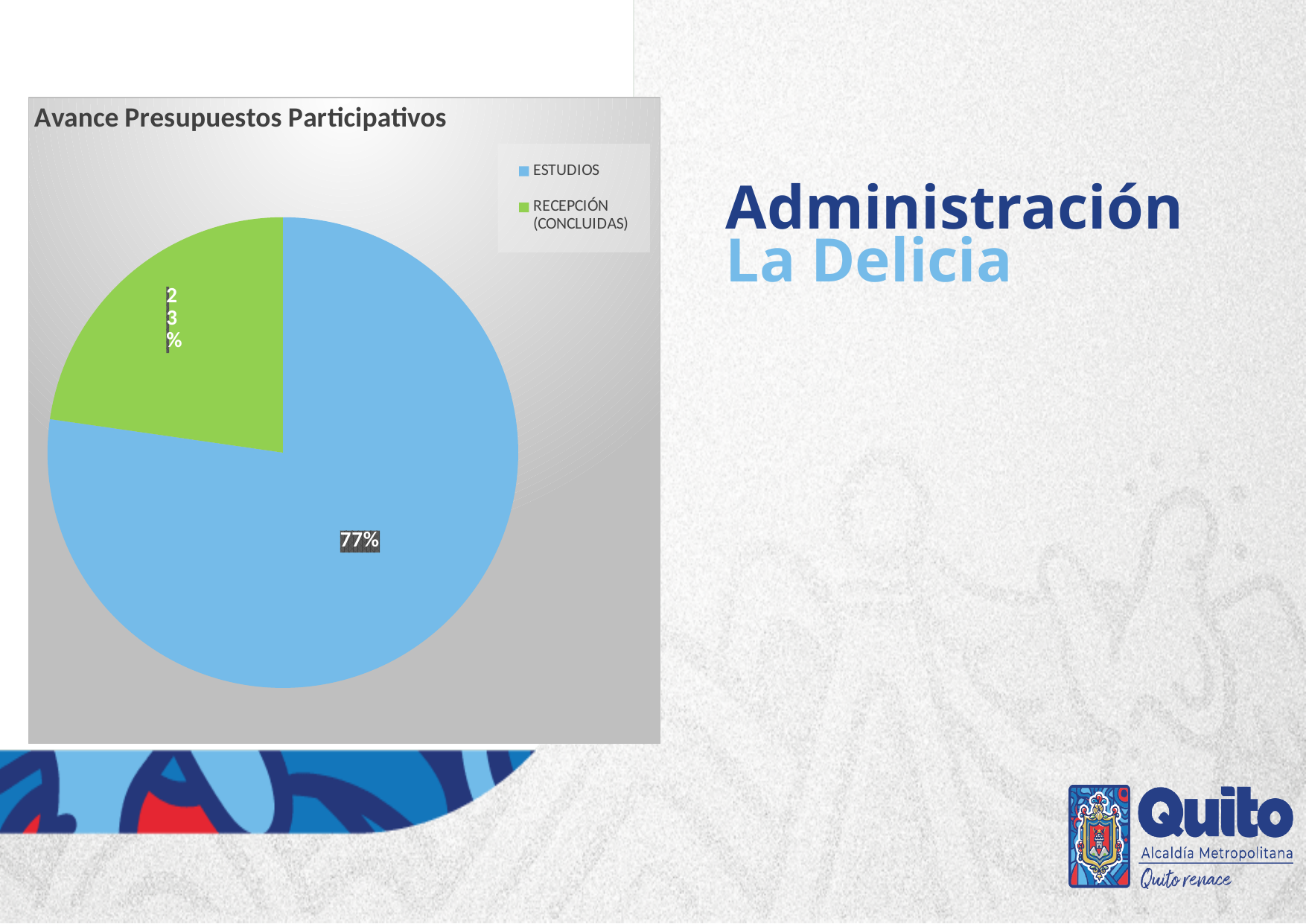
Which is larger, the share for ESTUDIOS or the share for RECEPCIÓN (CONCLUIDAS)? ESTUDIOS What is the difference in percentage points between ESTUDIOS and RECEPCIÓN (CONCLUIDAS)? 54 What is the title of the chart? Avance Presupuestos Participativos What percentage of the pie does ESTUDIOS represent? 77% What colour is the ESTUDIOS slice? blue Which category has the smallest share of the pie? RECEPCIÓN (CONCLUIDAS) What percentage of the pie does RECEPCIÓN (CONCLUIDAS) represent? 23% What kind of chart is shown on the slide? pie chart How many slices does the pie chart have? 2 How many entries does the legend list? 2 Which category has the largest share of the pie? ESTUDIOS